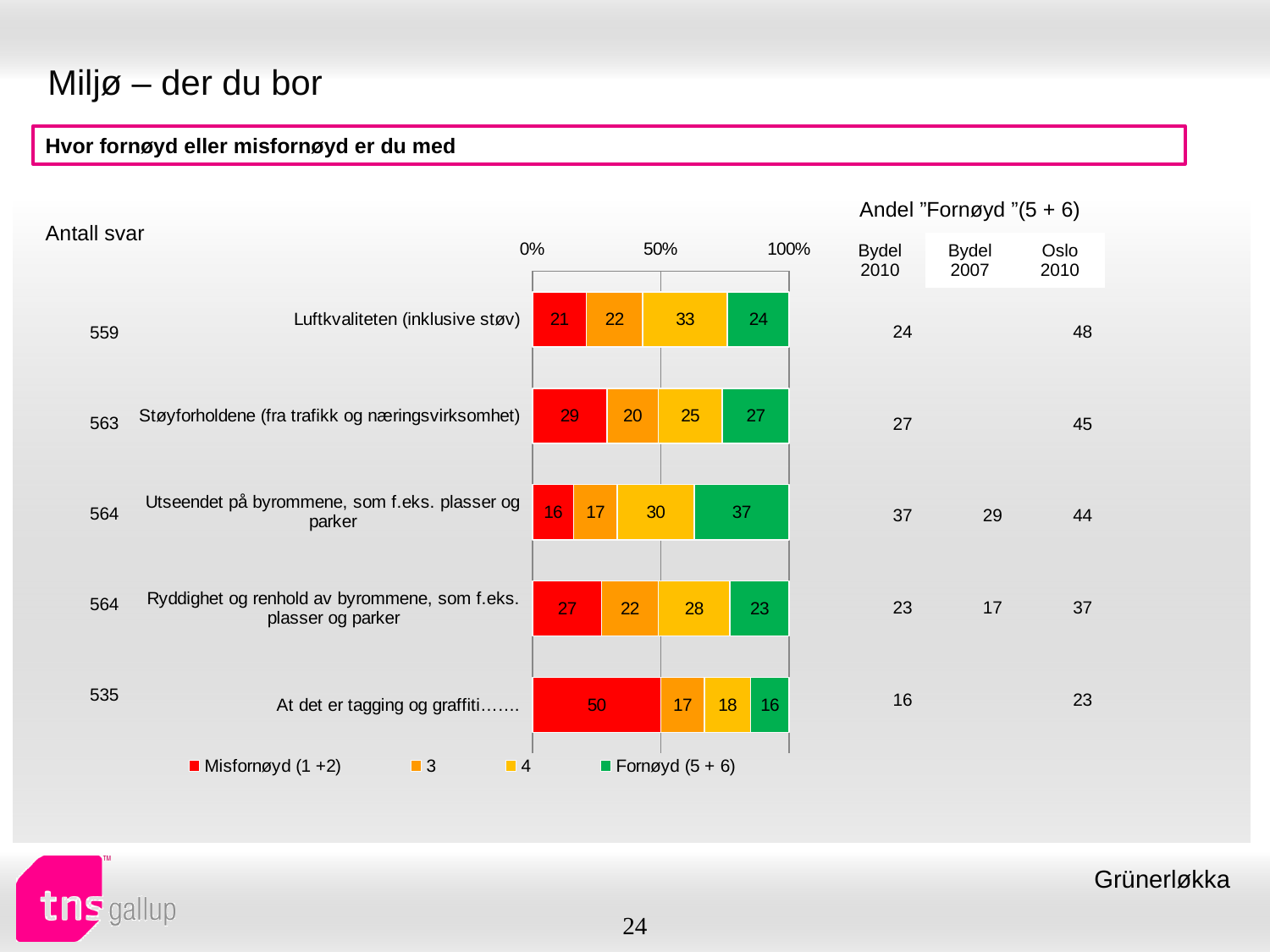
What is the difference between the 'Misfornøyd (1 +2)' value for 'At det er tagging og graffiti…….' and for 'Luftkvaliteten (inklusive støv)'? 29 What is the value of series '4' for 'Utseendet på byrommene, som f.eks. plasser og parker'? 30 What is the 'Misfornøyd (1 +2)' value for 'At det er tagging og graffiti…….'? 50 Which category has the highest 'Fornøyd (5 + 6)' value? Utseendet på byrommene, som f.eks. plasser og parker What is the total of the stacked bar for 'Luftkvaliteten (inklusive støv)'? 100 How many series does the chart legend list? 4 What is the 'Fornøyd (5 + 6)' value for 'Luftkvaliteten (inklusive støv)'? 24 Which category has the lowest 'Misfornøyd (1 +2)' value? Utseendet på byrommene, som f.eks. plasser og parker Which is larger: the 'Fornøyd (5 + 6)' value for 'Støyforholdene (fra trafikk og næringsvirksomhet)' or for 'Ryddighet og renhold av byrommene, som f.eks. plasser og parker'? Støyforholdene (fra trafikk og næringsvirksomhet) How many categories (statements) are plotted in the chart? 5 Which colour represents the 'Fornøyd (5 + 6)' series in the chart? green What type of chart is shown on the slide? stacked bar chart